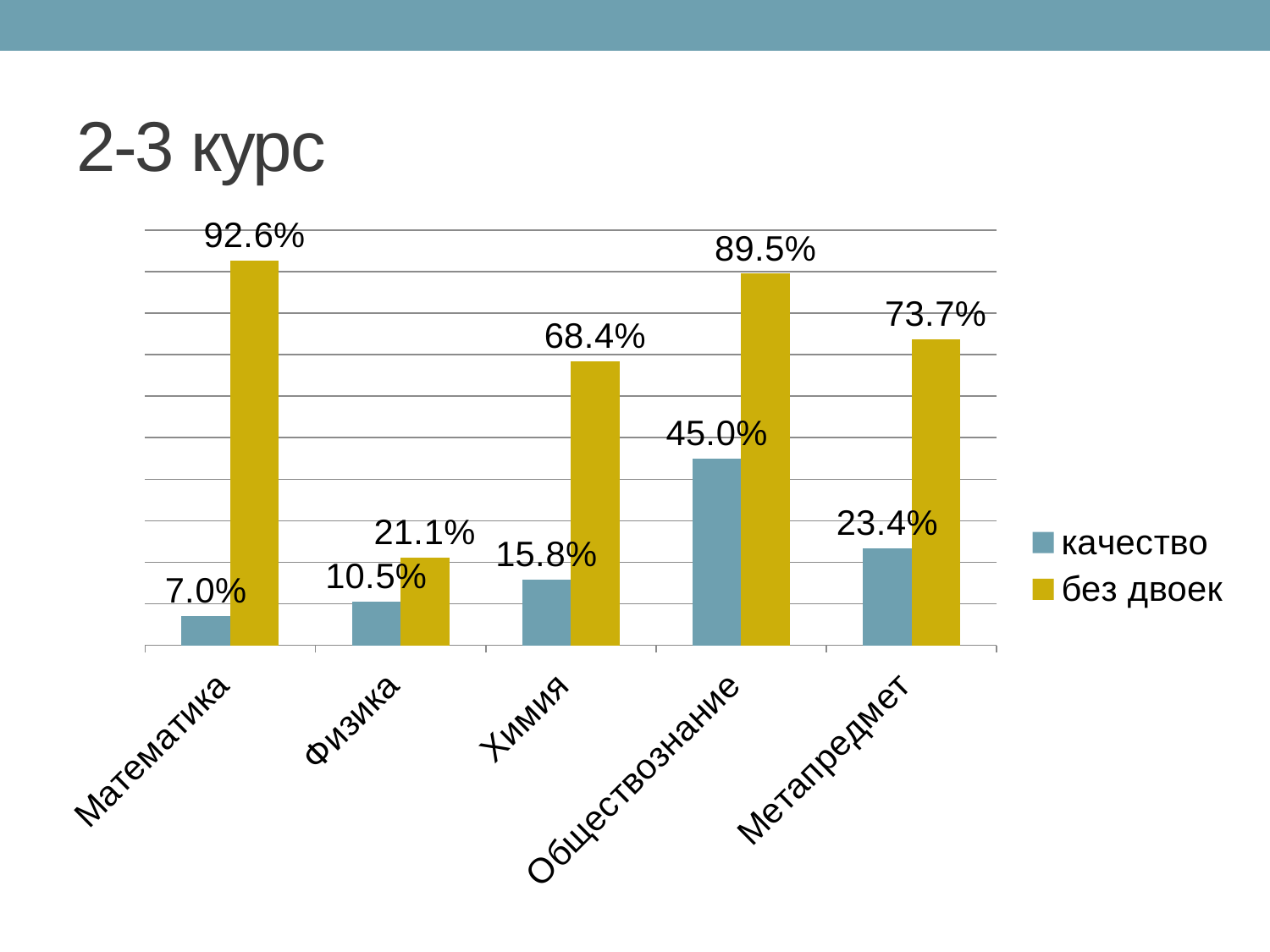
Which category has the highest 'качество' value? Обществознание What is the difference between 'без двоек' and 'качество' for Физика? 10.6% What is the value of 'качество' for Метапредмет? 23.4% Which category has the lowest 'без двоек' value? Физика What is the value of 'качество' for Обществознание? 45.0% What is the value of 'без двоек' for Математика? 92.6% How many categories are shown on the x axis? 5 What is the value of 'без двоек' for Химия? 68.4% How many series does the legend list? 2 What kind of chart is shown on the slide? bar chart Which category has the lowest 'качество' value? Математика Which is larger: 'без двоек' for Обществознание or 'без двоек' for Метапредмет? Обществознание